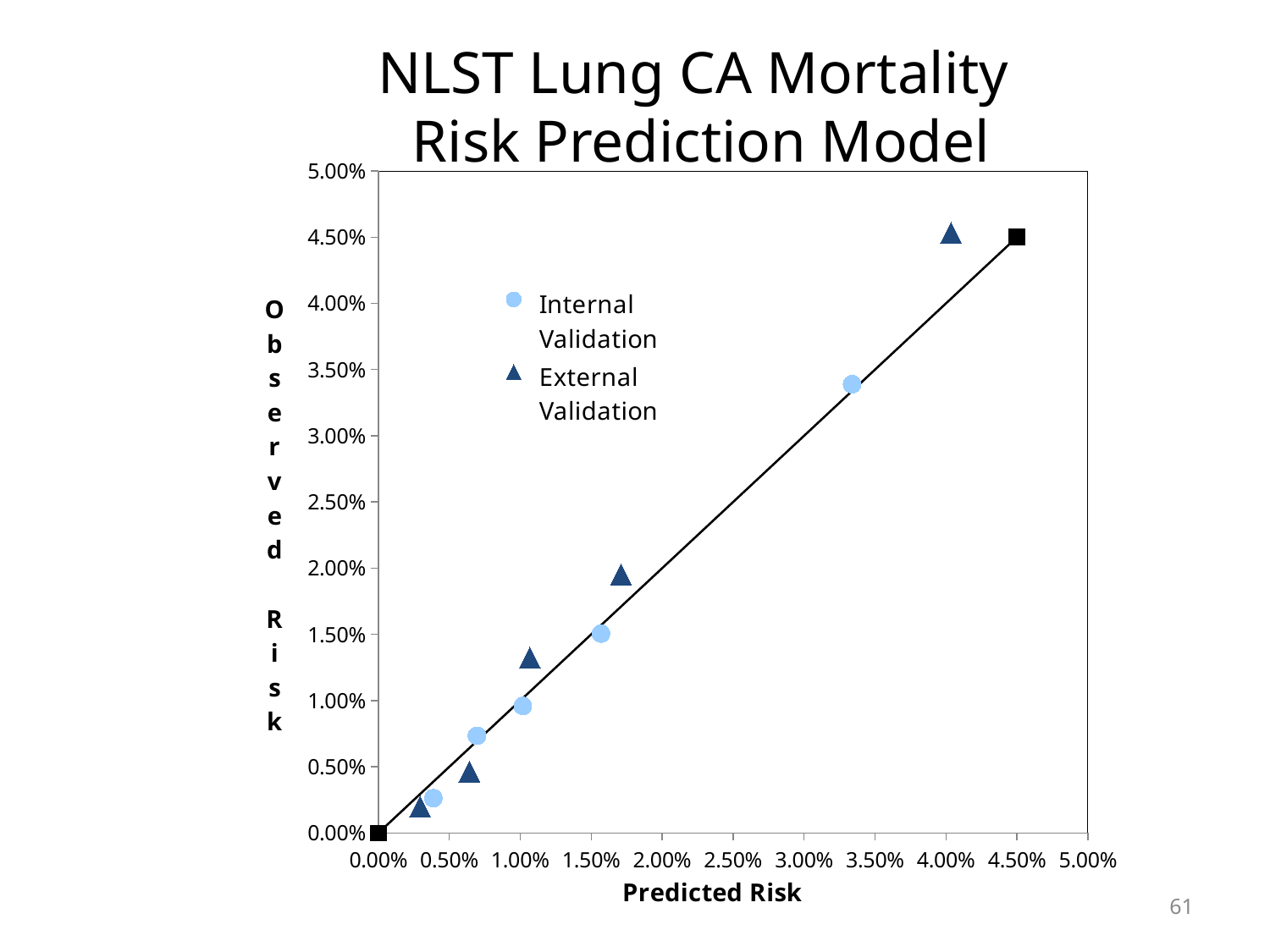
How many External Validation points are plotted? 5 Which series contains the point with the highest observed risk? External Validation What is the title of the chart? NLST Lung CA Mortality Risk Prediction Model As predicted risk increases along the x axis, does observed risk rise or fall? Rise Which is higher: the observed risk of the highest External Validation point or the observed risk of the highest Internal Validation point? External Validation What kind of chart is shown on the slide? Scatter chart How many series does the legend list? 2 What is the title of the x axis? Predicted Risk Is the observed risk of the highest Internal Validation point greater or less than 3.00%? greater How many Internal Validation points are plotted? 5 Is the observed risk of the lowest Internal Validation point greater or less than 0.50%? less Is the observed risk of the highest External Validation point greater or less than 4.00%? greater